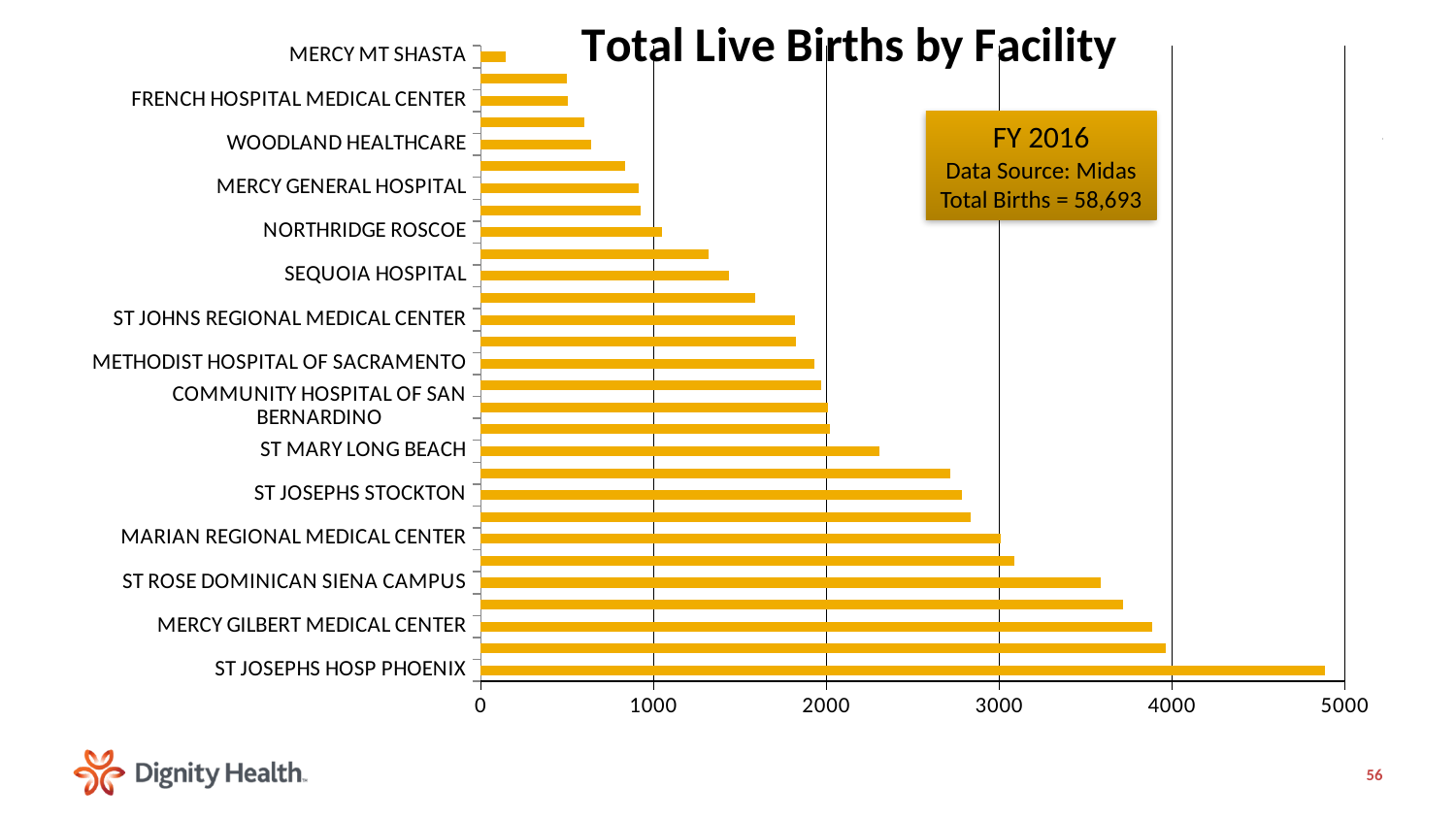
Is the value for WOODLAND HEALTHCARE greater or less than 1000? less Is the value for ST MARY LONG BEACH greater or less than 2000? greater Is the value for ST JOSEPHS HOSP PHOENIX greater or less than 4000? greater What kind of chart is shown on the slide? Bar chart Which facility has the highest number of live births? ST JOSEPHS HOSP PHOENIX Which has more live births, ST JOSEPHS STOCKTON or SEQUOIA HOSPITAL? ST JOSEPHS STOCKTON Which facility has the lowest number of live births? MERCY MT SHASTA What is the title of the chart? Total Live Births by Facility According to the text box on the chart, what is the total number of births? 58,693